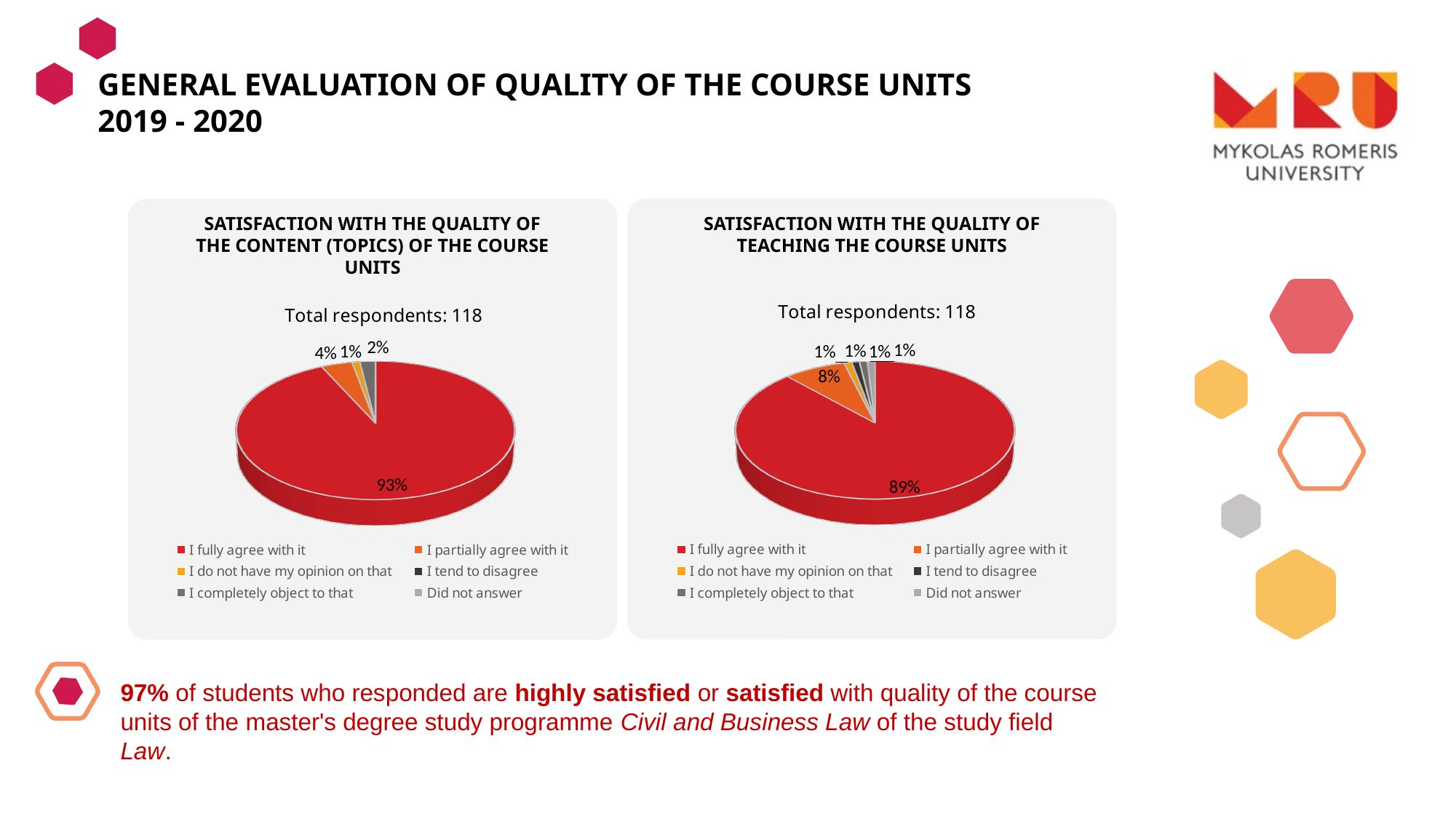
In the right chart (satisfaction with the quality of teaching the course units), what share is labelled for the 'I partially agree with it' slice? 8% Which chart shows a higher share for 'I fully agree with it': the left chart on content or the right chart on teaching? The left chart (content) What type of chart is used in the left chart (satisfaction with the quality of the content of the course units)? Pie chart What is the difference in percentage points between the 'I fully agree with it' share in the left chart (93%) and in the right chart (89%)? 4 percentage points In the left chart (satisfaction with the quality of the content of the course units), what percentage of respondents chose 'I fully agree with it'? 93% What is the title of the right chart? Satisfaction with the quality of teaching the course units How many total respondents are reported for the left chart (satisfaction with the quality of the content of the course units)? 118 How many response categories does the legend of the right chart (satisfaction with the quality of teaching the course units) list? 6 In the left chart (satisfaction with the quality of the content of the course units), which response category has the largest slice? I fully agree with it In the right chart (satisfaction with the quality of teaching the course units), what percentage of respondents chose 'I fully agree with it'? 89% In the right chart (satisfaction with the quality of teaching the course units), which response category has the largest slice? I fully agree with it In the left chart (satisfaction with the quality of the content of the course units), what share is labelled for the 'I partially agree with it' slice? 4%